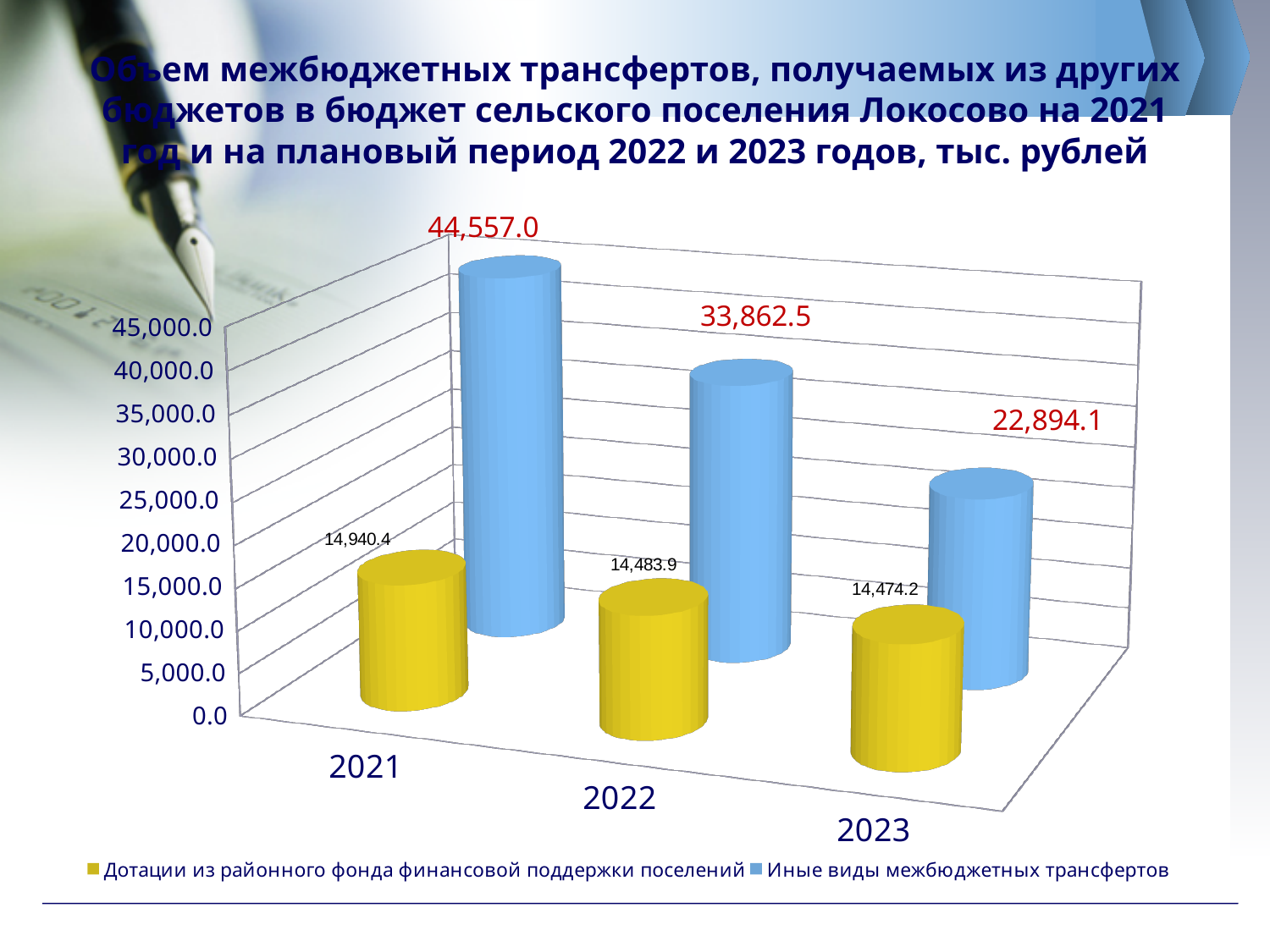
What is the value of Дотации из районного фонда финансовой поддержки поселений for 2023? 14,474.2 By how much does Иные виды межбюджетных трансфертов in 2022 exceed the value in 2023? 10,968.4 How does Иные виды межбюджетных трансфертов change from 2021 to 2023? It falls What is the value of Дотации из районного фонда финансовой поддержки поселений for 2022? 14,483.9 What is the value of Иные виды межбюджетных трансфертов for 2021? 44,557.0 What is the value of Иные виды межбюджетных трансфертов for 2023? 22,894.1 What kind of chart is shown on the slide? Bar chart What is the difference between Иные виды межбюджетных трансфертов and Дотации из районного фонда финансовой поддержки поселений in 2021? 29,616.6 In which year is Иные виды межбюджетных трансфертов lowest? 2023 How many series does the legend list? 2 In which year is Иные виды межбюджетных трансфертов highest? 2021 Which is larger in 2022: Дотации из районного фонда финансовой поддержки поселений or Иные виды межбюджетных трансфертов? Иные виды межбюджетных трансфертов